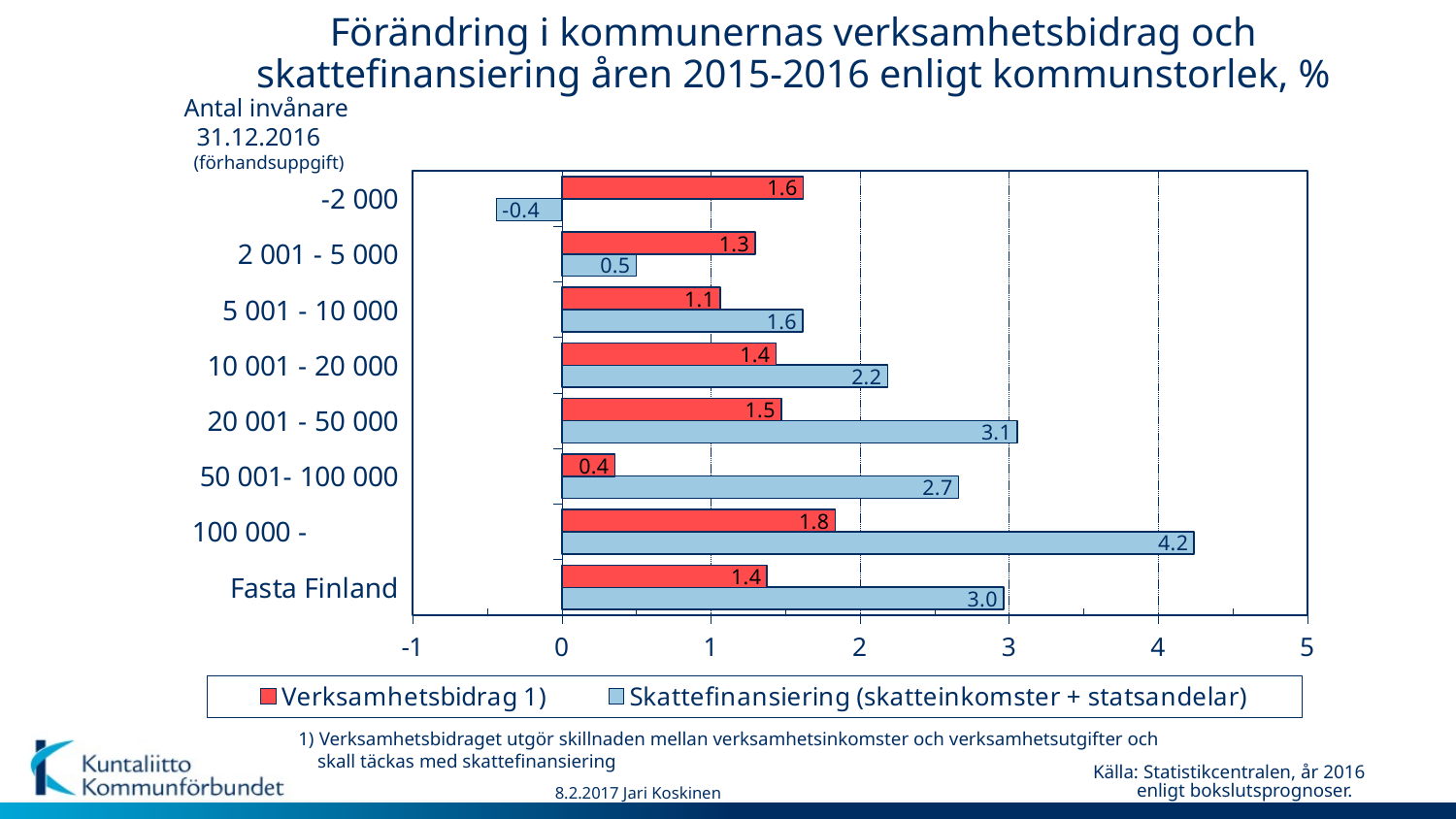
What type of chart is shown on the slide? bar chart Which category has the lowest Verksamhetsbidrag value? 50 001- 100 000 What is the Skattefinansiering value for the category -2 000? -0.4 How many series does the legend list? 2 Which category has the highest Skattefinansiering value? 100 000 - Which colour represents the Skattefinansiering series in the chart? light blue What is the difference between the Skattefinansiering and Verksamhetsbidrag values for Fasta Finland? 1.6 For the category 2 001 - 5 000, which is larger: Verksamhetsbidrag or Skattefinansiering? Verksamhetsbidrag How many categories are shown on the vertical axis of the chart? 8 Which category has the highest Verksamhetsbidrag value? 100 000 - What is the Verksamhetsbidrag value for the category 50 001- 100 000? 0.4 What is the Skattefinansiering value for the category 100 000 -? 4.2